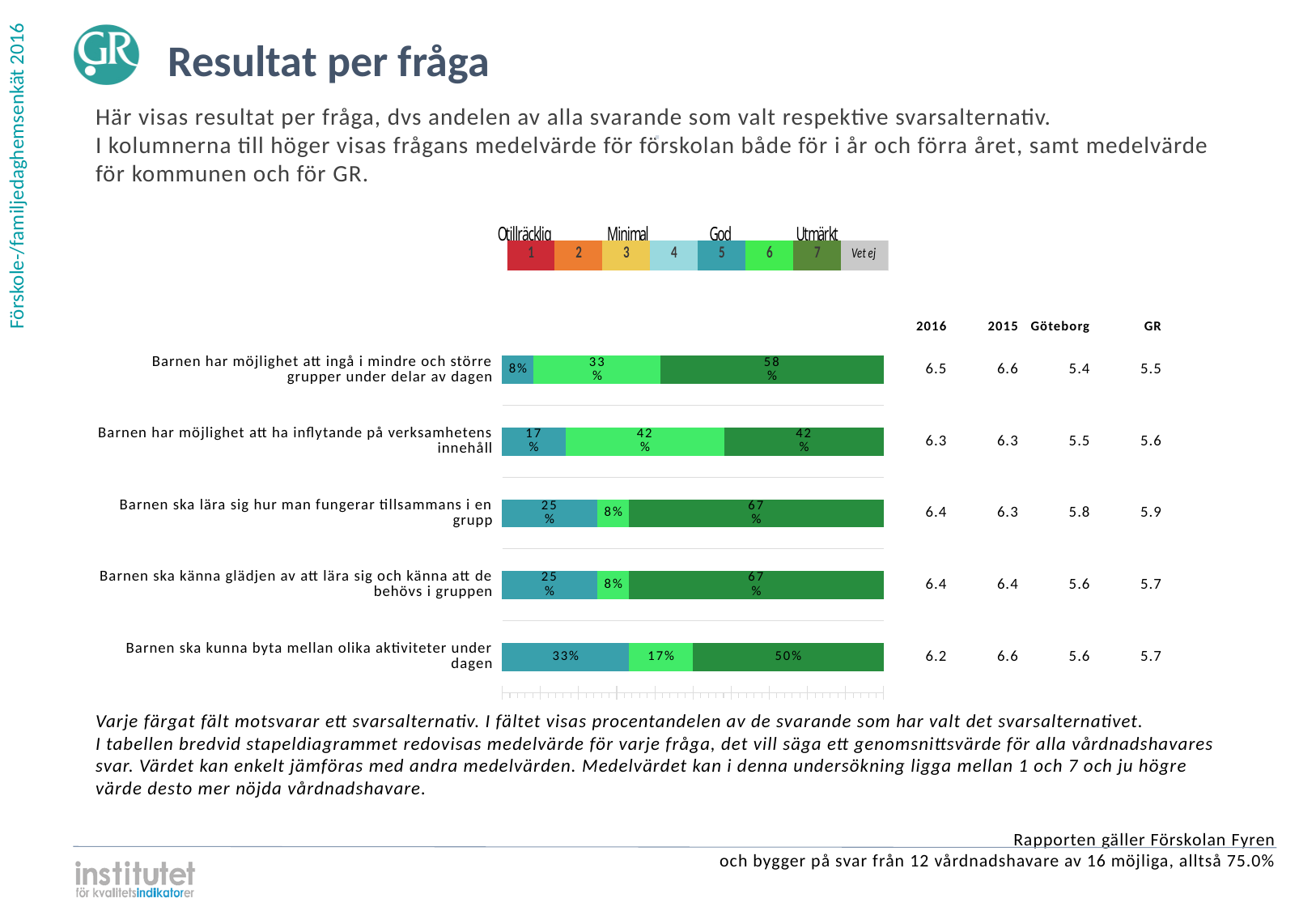
How many response options are shown in the colour legend above the chart, including "Vet ej"? 8 What percentage of respondents chose option 5 (teal) for "Barnen ska kunna byta mellan olika aktiviteter under dagen"? 33% Which question has the smallest share of respondents choosing option 5 (teal)? Barnen har möjlighet att ingå i mindre och större grupper under delar av dagen Is the option 6 (light green) share larger for "Barnen har möjlighet att ingå i mindre och större grupper under delar av dagen" or for "Barnen ska kunna byta mellan olika aktiviteter under dagen"? Barnen har möjlighet att ingå i mindre och större grupper under delar av dagen How many questions (categories) are shown in the bar chart? 5 What percentage chose option 6 (light green) for "Barnen har möjlighet att ha inflytande på verksamhetens innehåll"? 42% What type of chart is used to show the results per question? stacked bar chart What is the difference between the option 7 share for "Barnen ska lära sig hur man fungerar tillsammans i en grupp" (67%) and for "Barnen ska kunna byta mellan olika aktiviteter under dagen" (50%)? 17 percentage points What percentage of respondents chose option 7 (dark green) for "Barnen har möjlighet att ingå i mindre och större grupper under delar av dagen"? 58% What is the 2016 mean value for "Barnen ska kunna byta mellan olika aktiviteter under dagen"? 6.2 Which question has the largest share of respondents choosing option 7 (dark green)? Barnen ska lära sig hur man fungerar tillsammans i en grupp (and Barnen ska känna glädjen av att lära sig och känna att de behövs i gruppen), 67% What is the GR mean value for "Barnen ska lära sig hur man fungerar tillsammans i en grupp"? 5.9